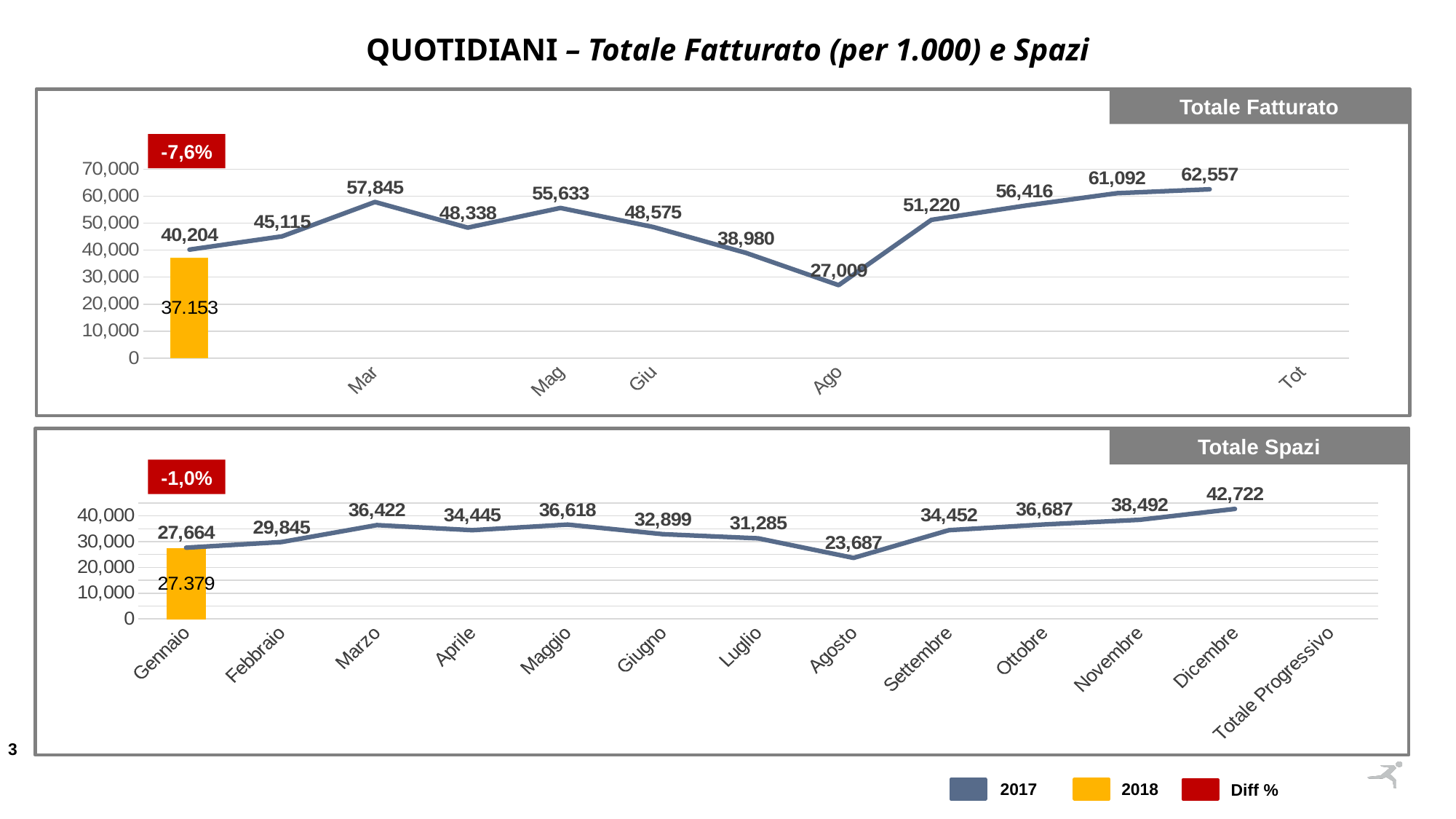
In the Totale Fatturato chart, what is the value of the 2018 bar? 37.153 In the Totale Spazi chart, what is the difference between the 2017 values for Dicembre and Agosto? 19,035 In the Totale Fatturato chart, what is the 2017 value for Ago? 27,009 In the Totale Spazi chart, which month has the lowest 2017 value? Agosto In the Totale Spazi chart, what is the 2017 value for Dicembre? 42,722 In the Totale Fatturato chart, what is the 2017 value for Mar? 57,845 In the Totale Fatturato chart, what is the difference between the 2017 values for Mar and Ago? 30,836 In the Totale Fatturato chart, which month has the lowest 2017 value? Ago What Diff % value is shown in the Totale Spazi chart? -1,0% In the Totale Spazi chart, which is larger, the 2017 value for Marzo or for Aprile? Marzo How many series does the legend at the bottom of the slide list? 3 In the Totale Spazi chart, which month has the highest 2017 value? Dicembre